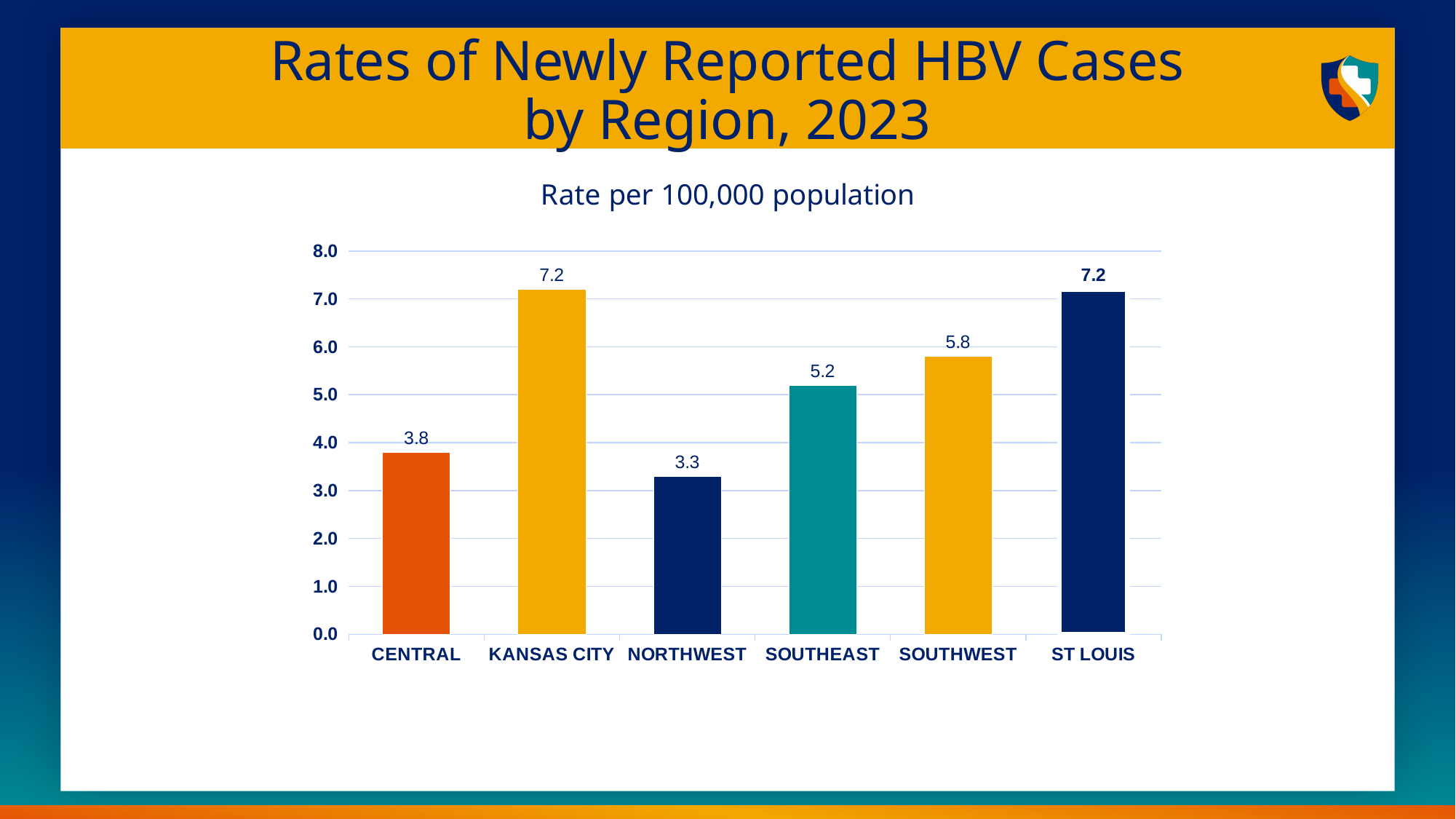
What is the rate for the Southeast region? 5.2 What is the difference between the rates for Kansas City and Central? 3.4 What kind of chart is shown on the slide? Bar chart What is the rate for the Northwest region? 3.3 Is the value for St Louis greater or less than 6.0? greater What unit is the rate expressed in, according to the chart subtitle? Rate per 100,000 population Which region has the lowest rate of newly reported HBV cases? Northwest How many regions are shown in the chart? 6 What is the rate for the Southwest region? 5.8 Which region has a higher rate, Southwest or Central? Southwest What is the difference between the rates for Southwest and Southeast? 0.6 What is the rate of newly reported HBV cases for the Central region? 3.8